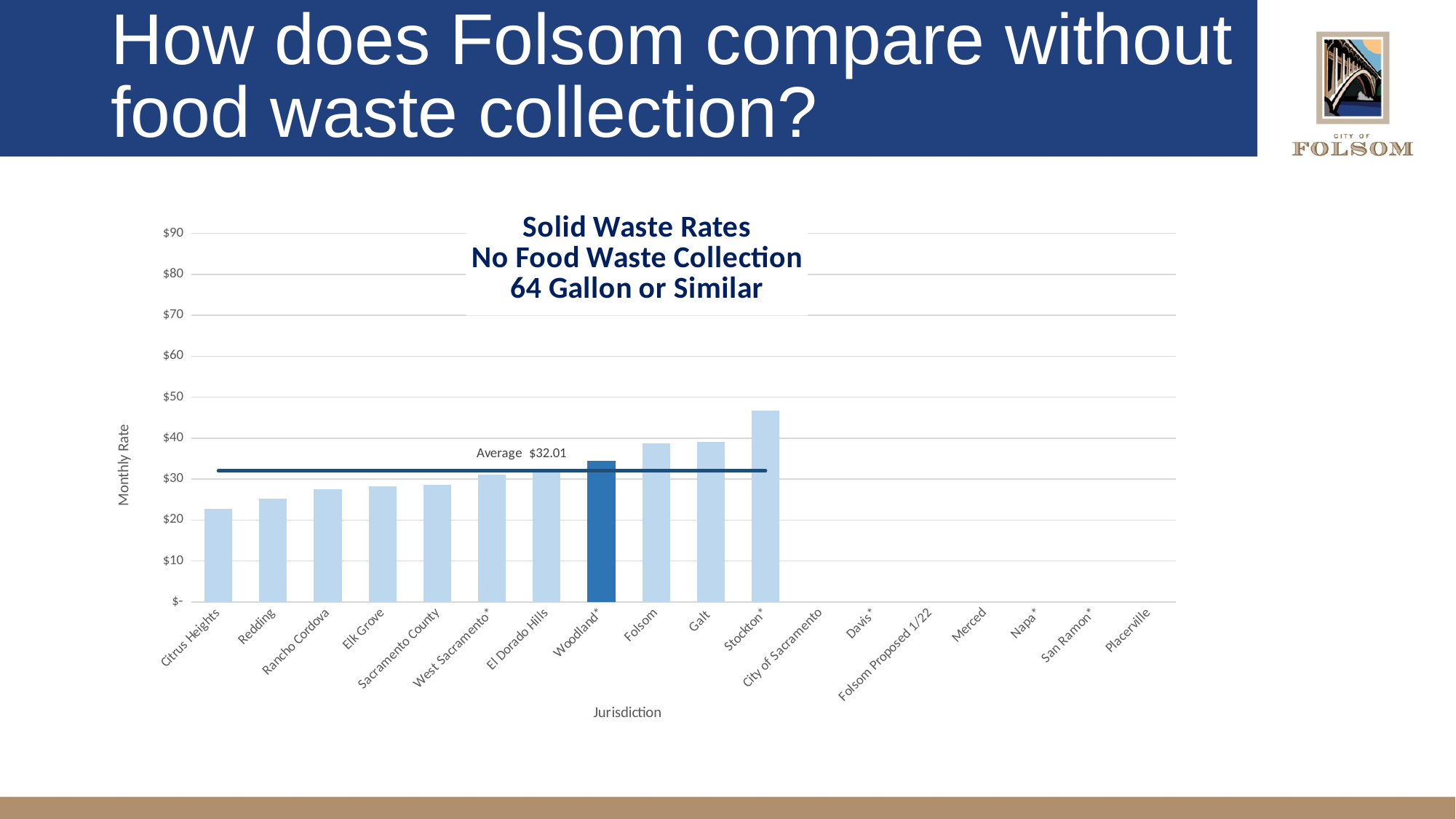
Do the bar values rise or fall from left to right along the x axis? rise Is the monthly rate for Redding greater or less than $30? less Which jurisdiction's bar is shown in a darker blue than the others? Woodland* What kind of chart is shown on the slide? bar chart Is the monthly rate for Folsom greater or less than $30? greater Which has a higher monthly rate, Folsom or Woodland*? Folsom What average value is labelled on the chart? $32.01 How many jurisdictions have a bar plotted in the chart? 11 Which jurisdiction has the lowest monthly rate in the chart? Citrus Heights What is the title of the vertical axis? Monthly Rate Which jurisdiction has the highest monthly rate in the chart? Stockton* Is the monthly rate for Stockton* greater or less than $40? greater